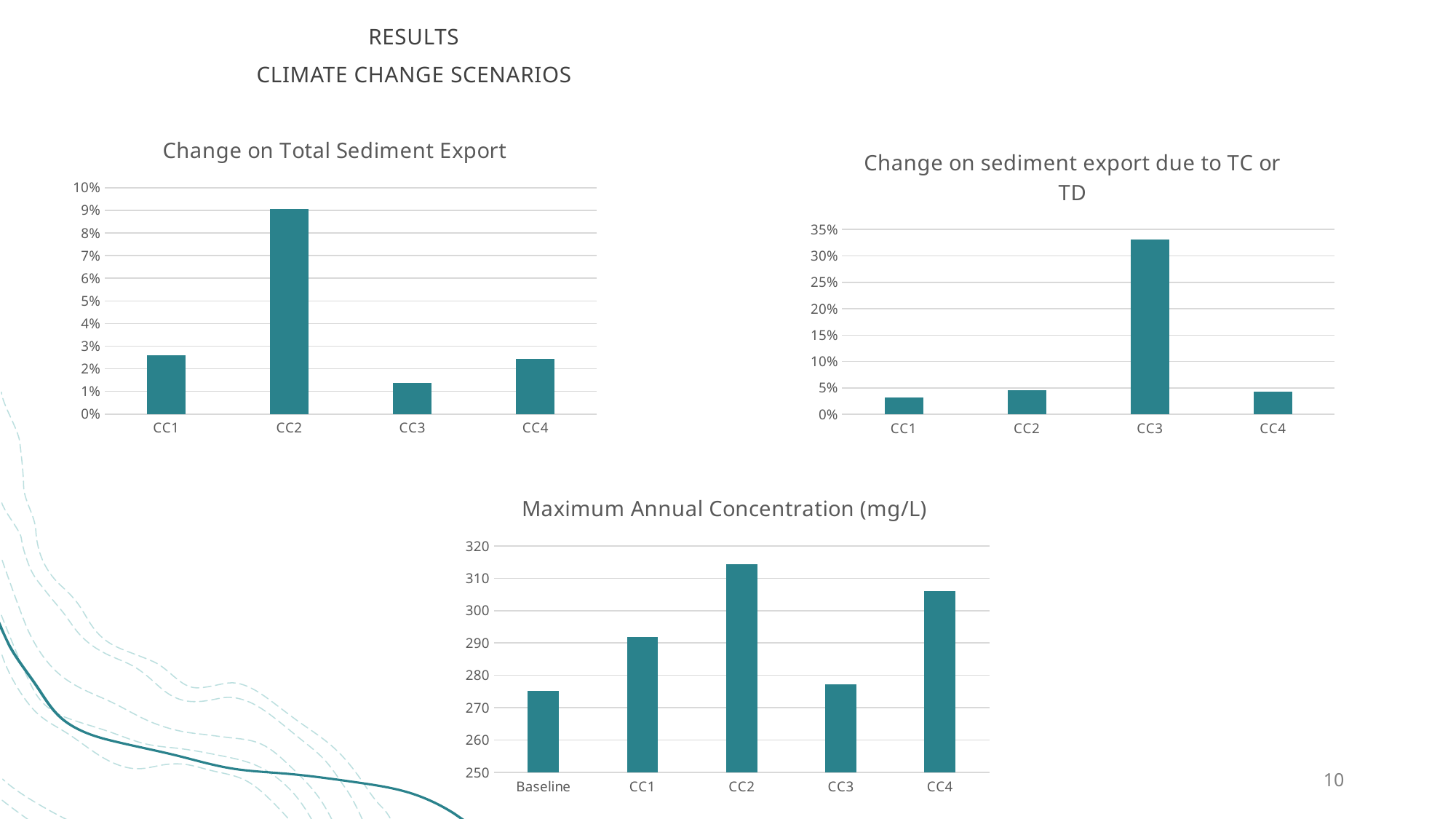
In the 'Change on sediment export due to TC or TD' chart, which scenario has the highest value? CC3 In the 'Maximum Annual Concentration (mg/L)' chart, which category has the highest value? CC2 In the 'Change on Total Sediment Export' chart, is the value for CC2 greater or less than 8%? greater How many categories are shown in the 'Maximum Annual Concentration (mg/L)' chart? 5 In the 'Change on Total Sediment Export' chart, which scenario has the highest value? CC2 In the 'Change on Total Sediment Export' chart, which scenario has the lowest value? CC3 In the 'Change on sediment export due to TC or TD' chart, which is larger, CC2 or CC3? CC3 In the 'Maximum Annual Concentration (mg/L)' chart, is the value for Baseline greater or less than 280? less In the 'Change on sediment export due to TC or TD' chart, is the value for CC1 greater or less than 5%? less In the 'Maximum Annual Concentration (mg/L)' chart, which is larger, CC2 or CC4? CC2